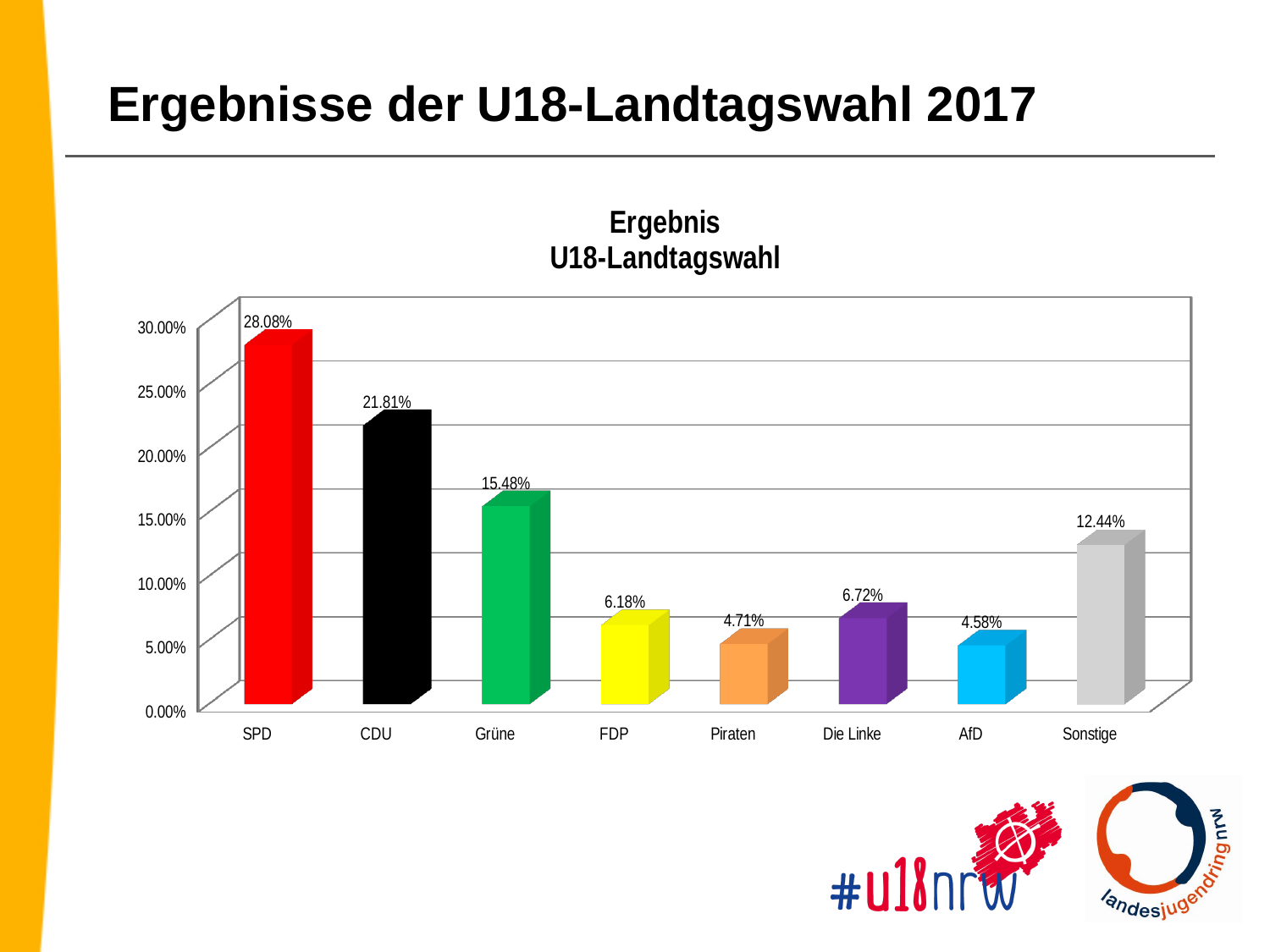
Is the value for CDU greater or less than 20.00%? greater What is the value for Grüne? 15.48% What is the difference between the values for SPD and CDU? 6.27% What is the value for Sonstige? 12.44% What is the value for SPD? 28.08% What colour is the bar for Grüne? green Which party has the lowest value? AfD Which party has the highest value? SPD What kind of chart is shown on the slide? bar chart How many parties are shown on the x axis? 8 What is the title of the chart? Ergebnis U18-Landtagswahl Which is larger, the value for FDP or the value for Die Linke? Die Linke